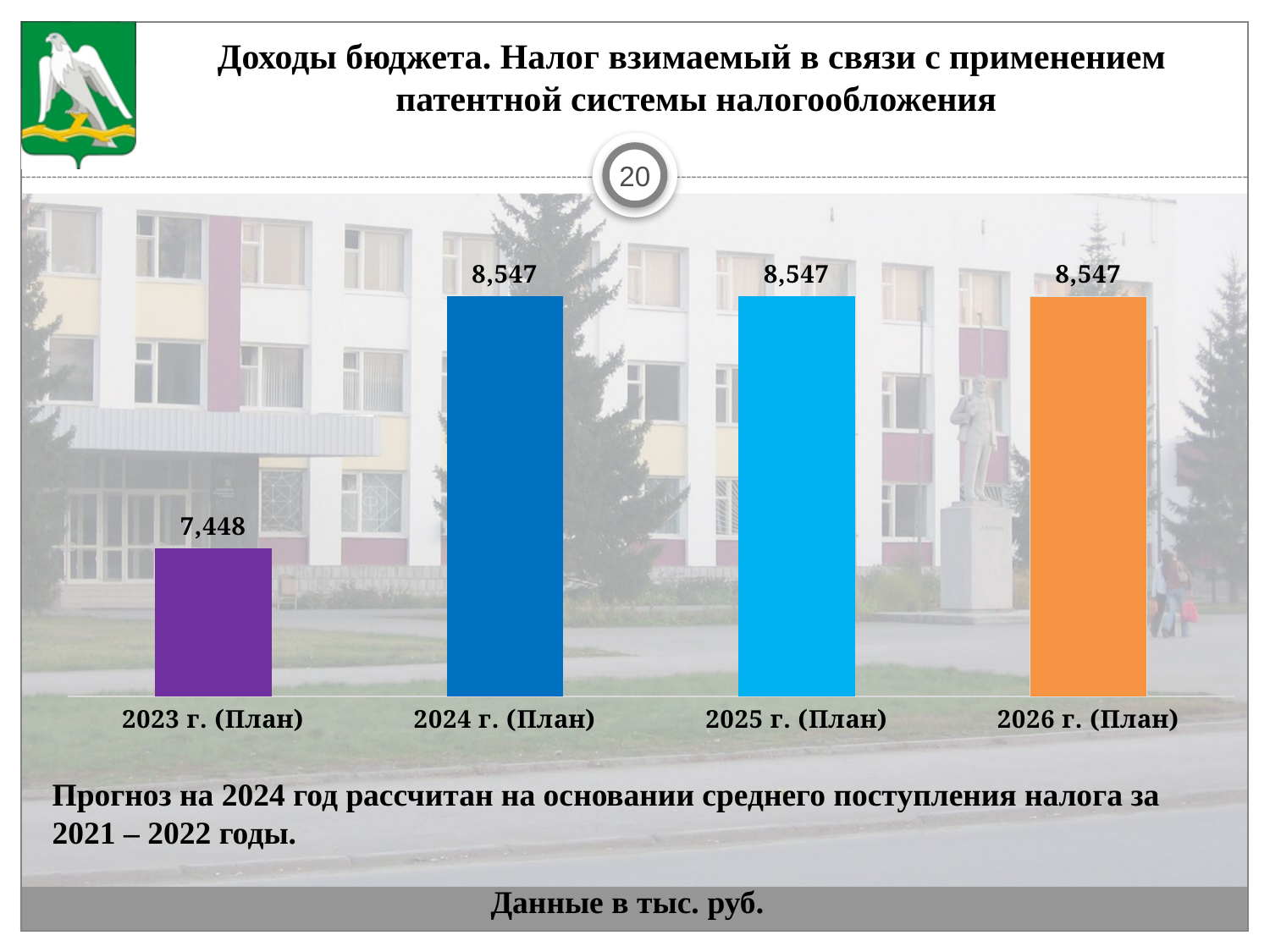
What is the value for 2023 г. (План)? 7,448 What is the value for 2024 г. (План)? 8,547 What kind of chart is shown on the slide? Bar chart In what units are the chart values given, according to the slide? тыс. руб. Which category has the lowest value? 2023 г. (План) Do the values change between 2024 г. (План) and 2026 г. (План)? No, they stay the same Which is larger, the value for 2023 г. (План) or the value for 2025 г. (План)? 2025 г. (План) What colour is the bar for 2023 г. (План)? Purple How many categories are shown on the chart? 4 Do the values rise or fall from 2023 г. (План) to 2024 г. (План)? Rise What is the difference between the values for 2024 г. (План) and 2023 г. (План)? 1,099 What is the value for 2026 г. (План)? 8,547